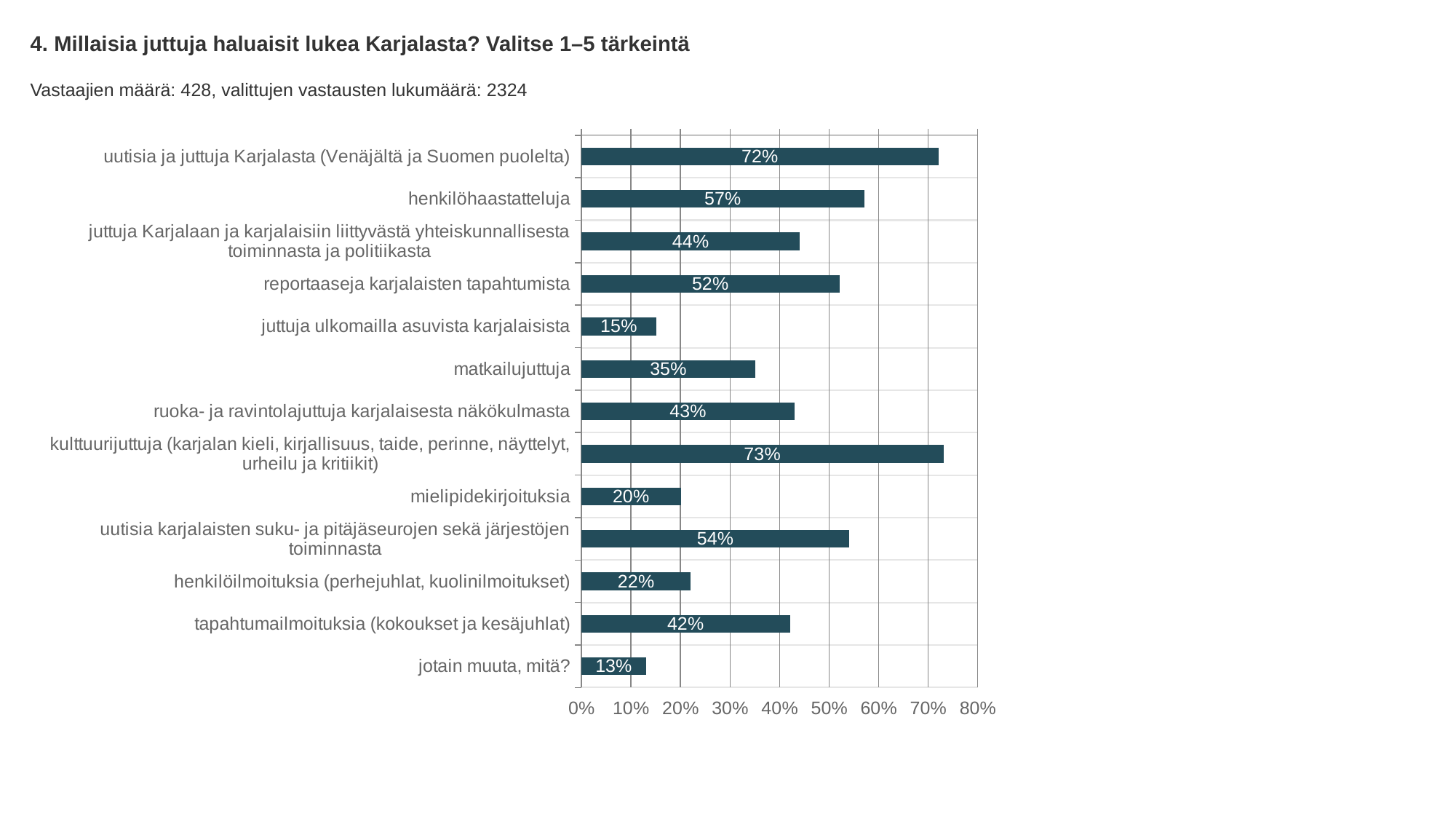
How many categories are shown in the chart? 13 What is the value for "matkailujuttuja"? 35% Is the value for "uutisia karjalaisten suku- ja pitäjäseurojen sekä järjestöjen toiminnasta" greater or less than 50%? greater Which category has the lowest value? jotain muuta, mitä? What is the difference between the values for "reportaaseja karjalaisten tapahtumista" and "juttuja ulkomailla asuvista karjalaisista"? 37% What is the value for "tapahtumailmoituksia (kokoukset ja kesäjuhlat)"? 42% What kind of chart is shown on the slide? bar chart What is the number of respondents (Vastaajien määrä) stated on the slide? 428 Which is larger, the value for "ruoka- ja ravintolajuttuja karjalaisesta näkökulmasta" or the value for "henkilöilmoituksia (perhejuhlat, kuolinilmoitukset)"? ruoka- ja ravintolajuttuja karjalaisesta näkökulmasta What is the value for "henkilöhaastatteluja"? 57% What is the value for "mielipidekirjoituksia"? 20% Which category has the highest value? kulttuurijuttuja (karjalan kieli, kirjallisuus, taide, perinne, näyttelyt, urheilu ja kritiikit)